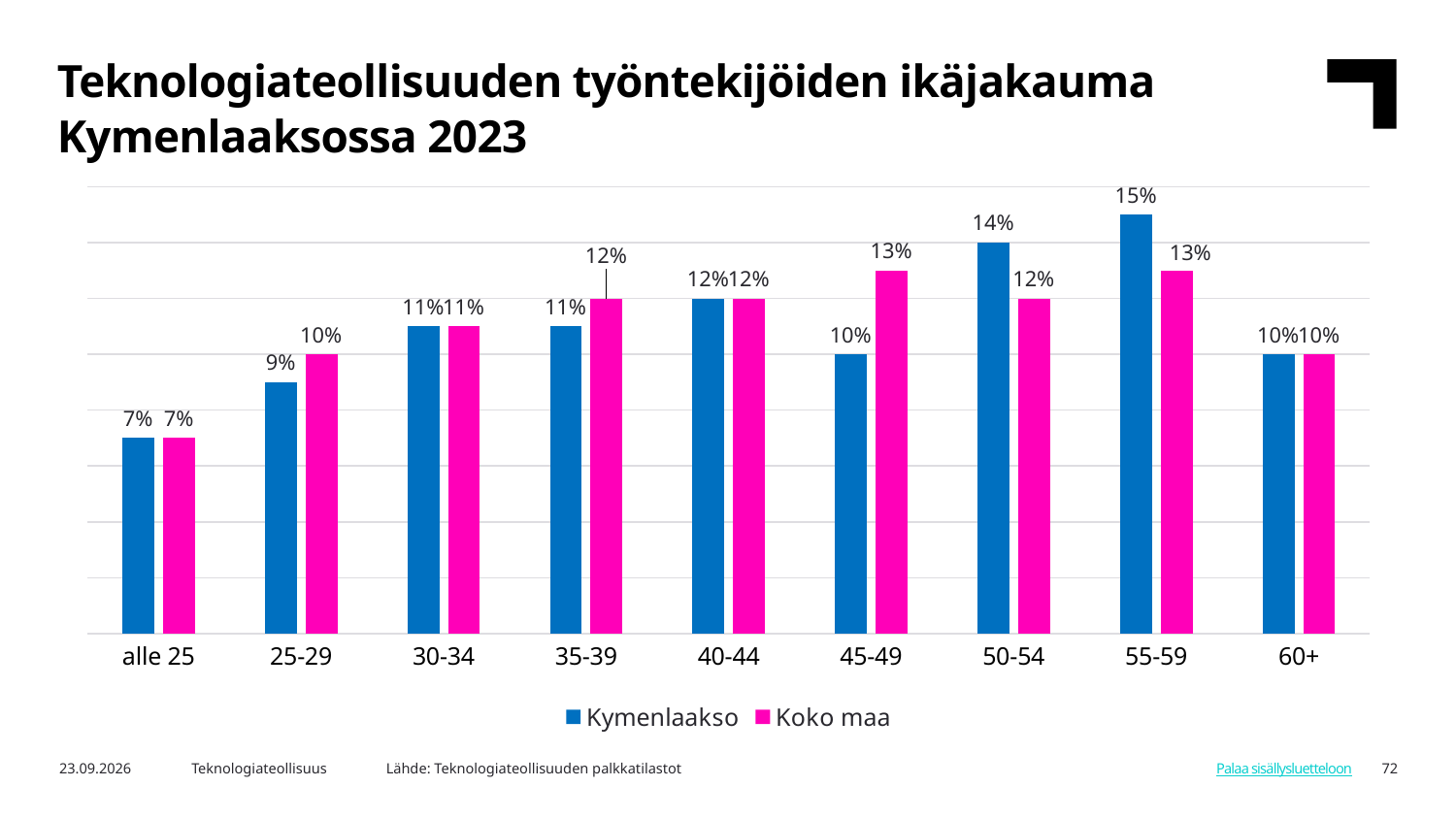
What kind of chart is shown on the slide? Bar chart What is the difference between the Koko maa and Kymenlaakso values for the 45-49 age group? 3 percentage points How many series does the legend list? 2 What is the Kymenlaakso value for the 25-29 age group? 9% Which age group has the highest Kymenlaakso value? 55-59 What is the title of the chart on the slide? Teknologiateollisuuden työntekijöiden ikäjakauma Kymenlaaksossa 2023 Which colour represents the Koko maa series? Pink What is the Kymenlaakso value for the 55-59 age group? 15% Which age group has the lowest Kymenlaakso value? alle 25 How many age groups are shown on the x axis? 9 What is the Koko maa value for the 45-49 age group? 13% For the 50-54 age group, which series has the larger value, Kymenlaakso or Koko maa? Kymenlaakso